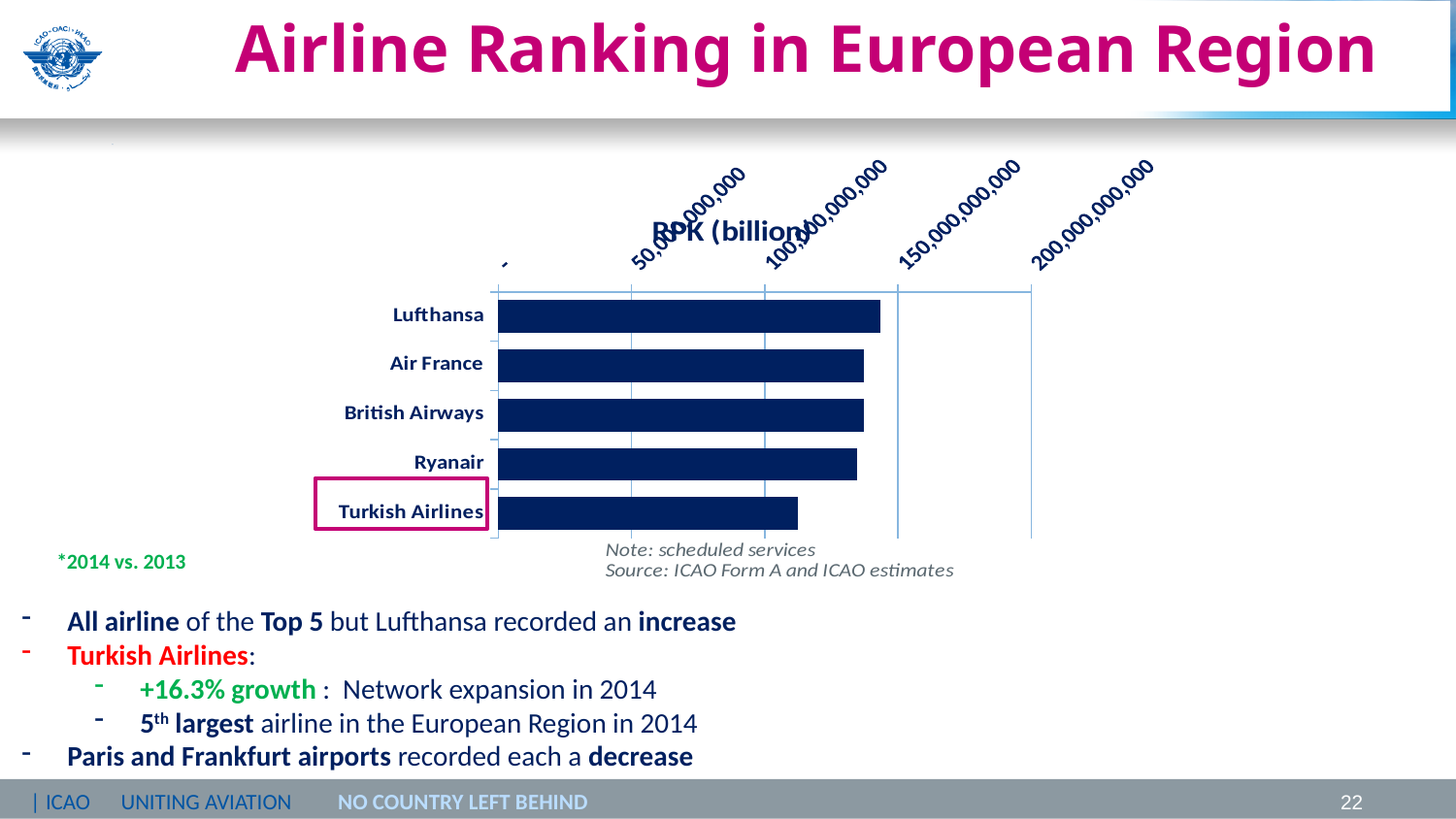
Is the value for Ryanair greater or less than 100,000,000,000? greater Is the value for Turkish Airlines greater or less than 150,000,000,000? less Which airline's label is highlighted with a box in the chart? Turkish Airlines Which has a larger RPK, Ryanair or Turkish Airlines? Ryanair Is the value for Turkish Airlines greater or less than 100,000,000,000? greater What kind of chart is shown on the slide? bar chart Which airline has the lowest RPK in the chart? Turkish Airlines How many airlines are shown in the chart? 5 What is the title of the chart? RPK (billions) Which has a larger RPK, Lufthansa or Turkish Airlines? Lufthansa Which airline has the highest RPK in the chart? Lufthansa